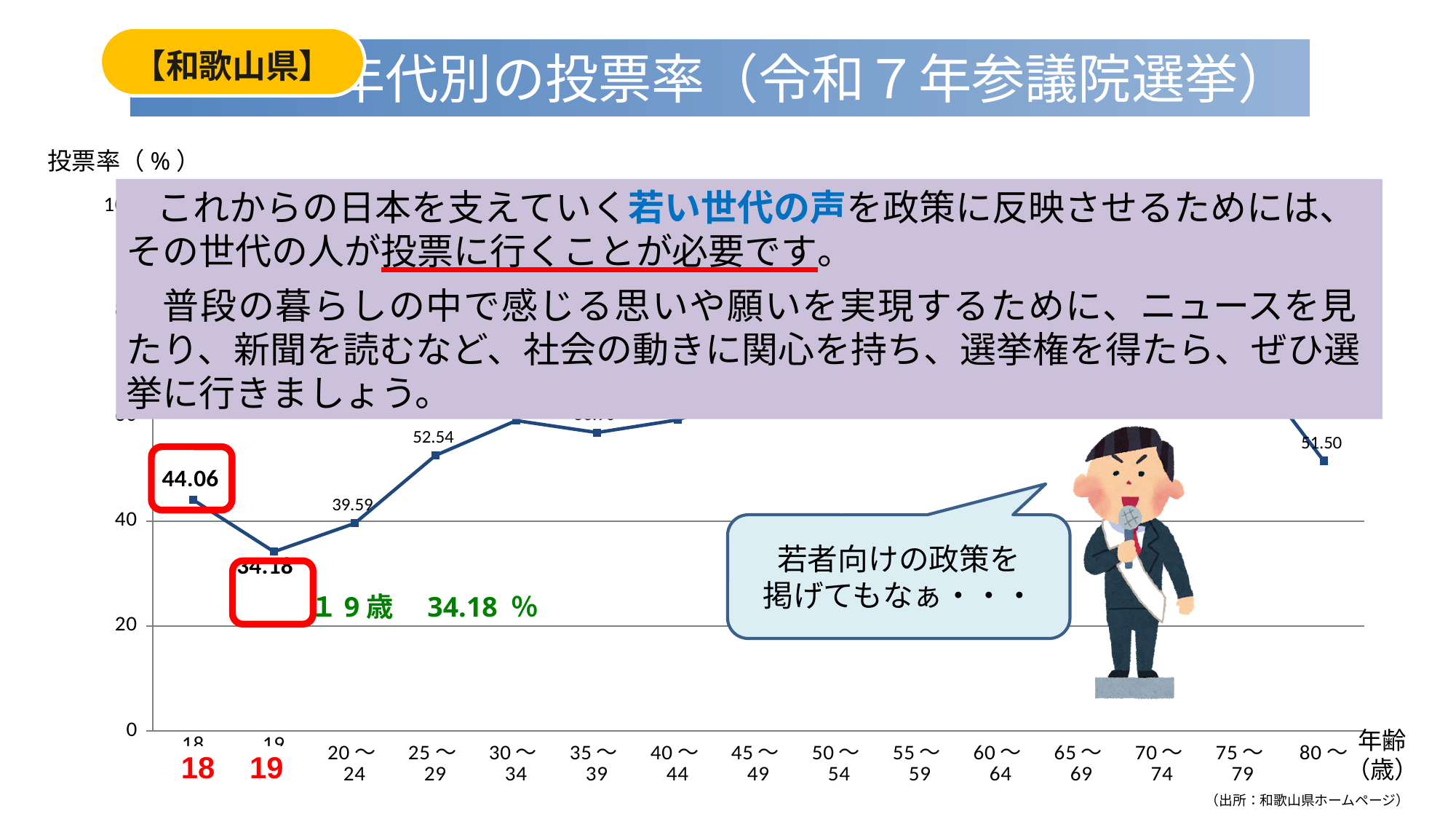
What is the voter turnout for 18-year-olds? 44.06 Is the turnout for 19-year-olds greater or less than 40? less Does the turnout rise or fall from age 19 to the 25～29 age group? rise Which has the higher turnout, 18-year-olds or the 20～24 age group? 18 What kind of chart is shown on the slide? line chart What is the difference in turnout between 18-year-olds and 19-year-olds? 9.88 Which age group has the lowest voter turnout? 19 What is the voter turnout for 19-year-olds? 34.18 What is the voter turnout for the 20～24 age group? 39.59 What is the voter turnout for the 25～29 age group? 52.54 How many age categories are shown on the x axis? 15 What is the voter turnout for the 80～ age group? 51.50